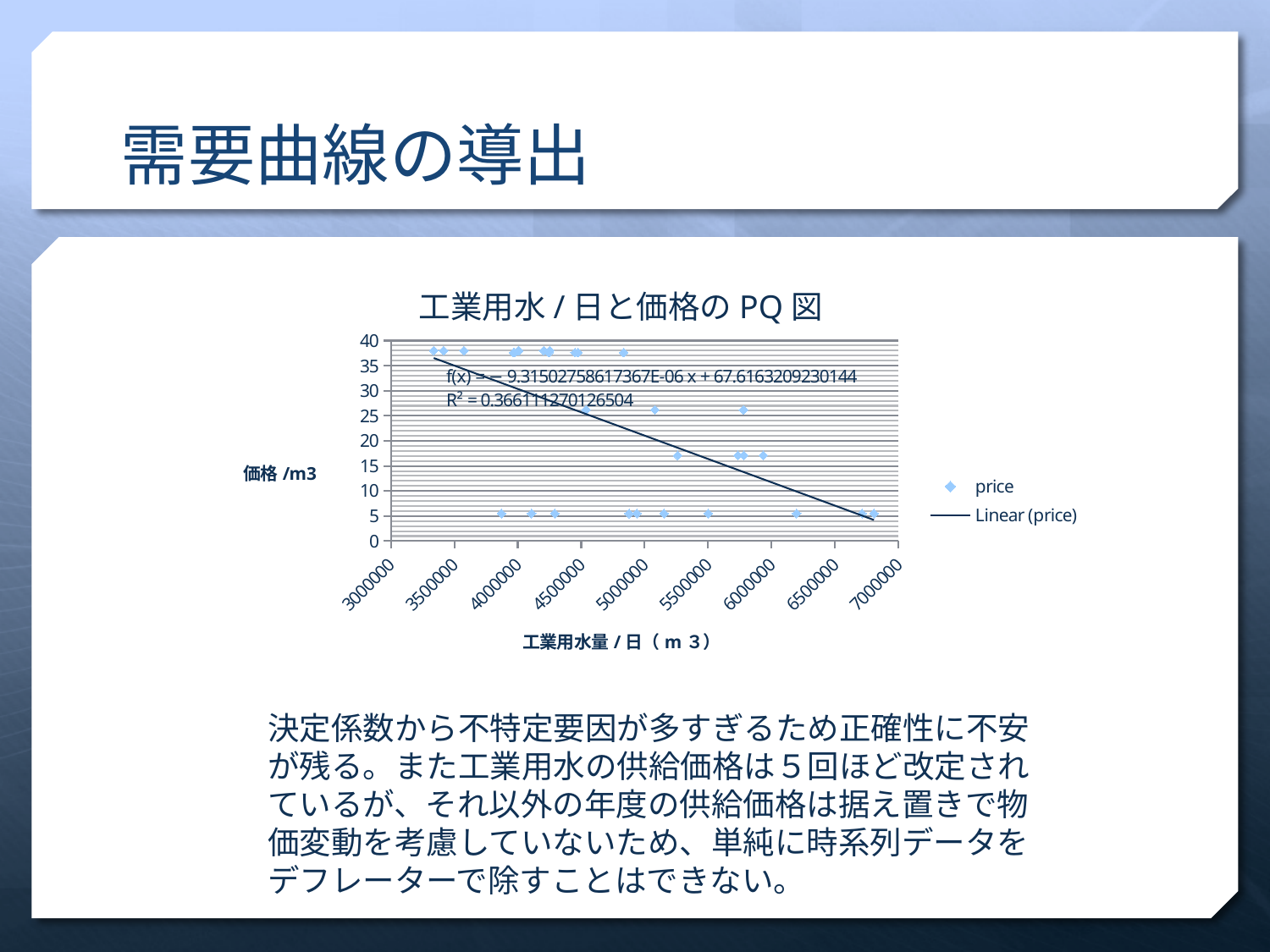
What kind of chart is shown on the slide? Scatter chart Does the linear trendline rise or fall as the x-axis value (工業用水量 / 日) increases? Fall What is the R² value shown on the chart? 0.366111270126504 What are the two entries in the chart legend? price, Linear (price) Are the price values for the points near 7000000 on the x axis greater or less than 10? less Are the price values for the points near 3500000 on the x axis greater or less than 35? greater What is the title of the chart? 工業用水 / 日と価格の PQ 図 Which is larger: the price of the points near 3500000 on the x axis or the price of the points near 7000000 on the x axis? The points near 3500000 How many entries does the chart legend list? 2 What is the intercept in the trendline equation f(x) shown on the chart? 67.6163209230144 What is the slope coefficient in the trendline equation f(x) shown on the chart? -9.31502758617367E-06 What is the maximum value shown on the y axis of the chart? 40